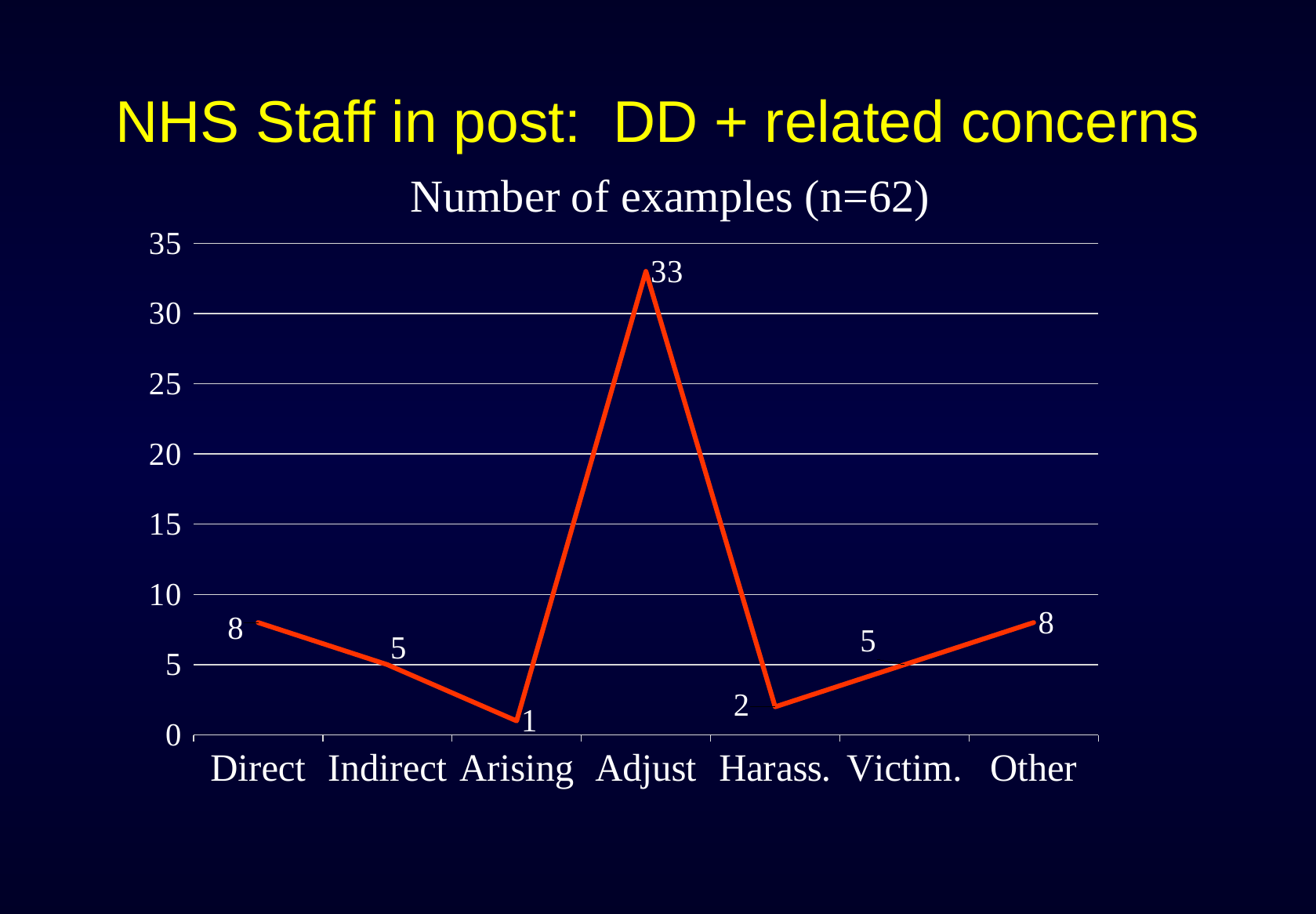
Which category has the highest value? Adjust What is the value for Adjust? 33 What is the value for Harass.? 2 What is the value for Arising? 1 How many categories are shown on the x axis? 7 What is the difference between the values for Adjust and Direct? 25 Do the values rise or fall from Direct to Arising? fall Which category has the lowest value? Arising What kind of chart is this? line chart What is the chart's title? Number of examples (n=62) Which is larger, the value for Victim. or the value for Harass.? Victim. Is the value for Adjust greater or less than 30? greater